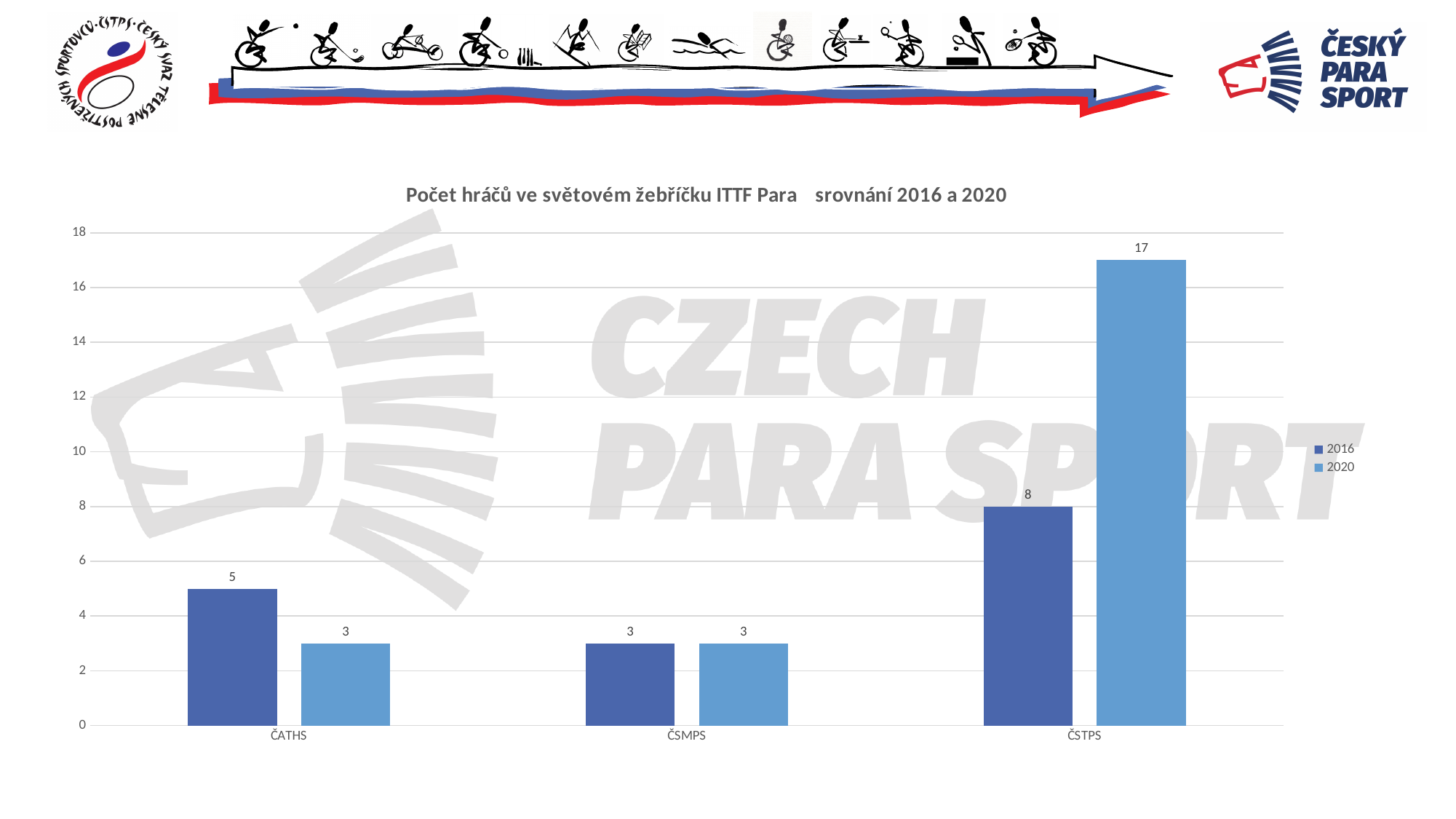
What is the value for ČATHS in 2016? 5 Which is larger for ČATHS: the 2016 value or the 2020 value? 2016 How many categories are shown on the x axis? 3 What is the value for ČSTPS in 2016? 8 What is the value for ČSTPS in 2020? 17 Which category has the lowest value in 2016? ČSMPS What is the difference between the 2020 and 2016 values for ČSTPS? 9 How many series does the legend list? 2 Which category has the highest value in 2020? ČSTPS What kind of chart is shown on the slide? bar chart What are the two series listed in the legend? 2016 and 2020 What is the value for ČSMPS in 2020? 3